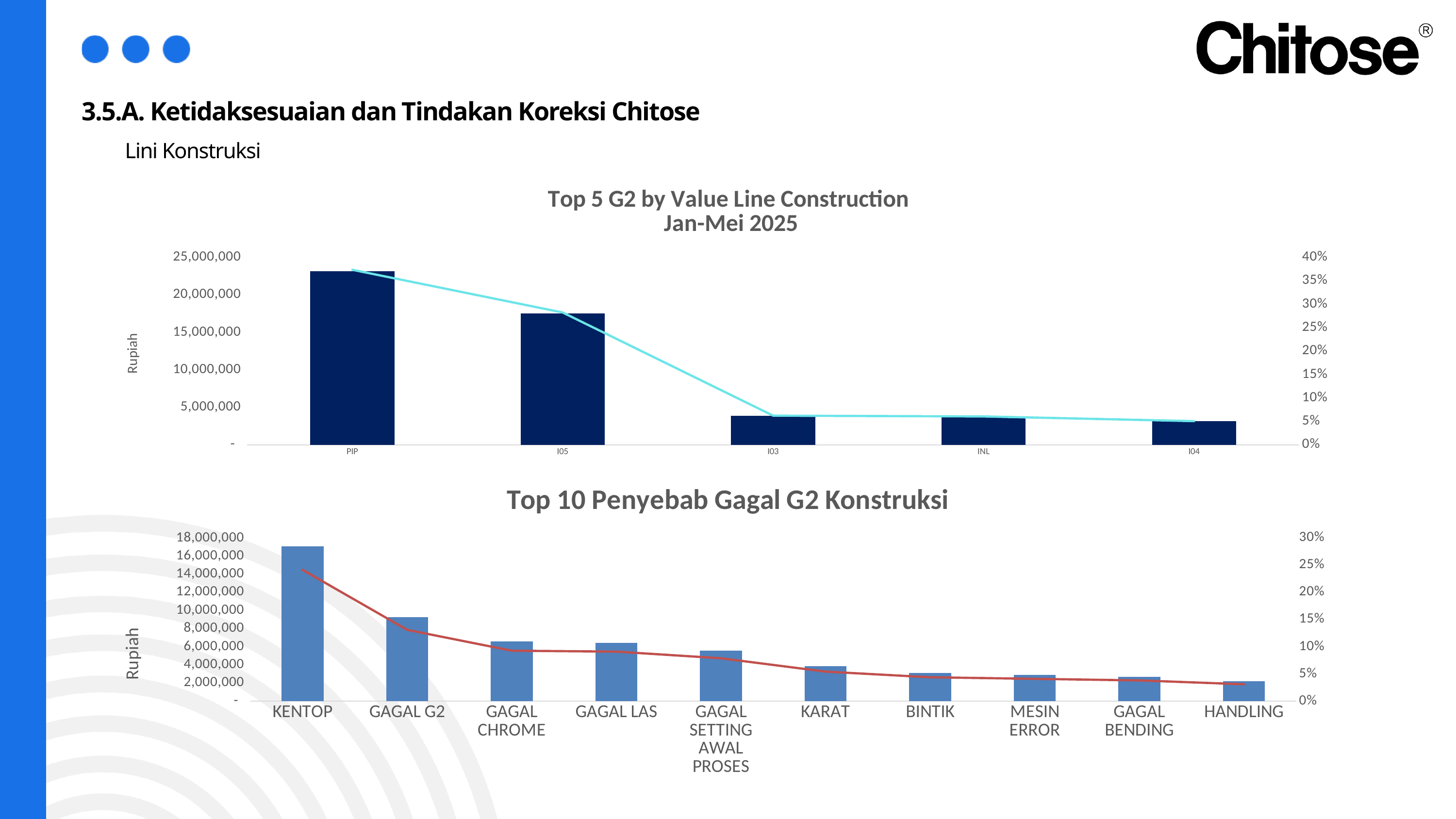
In the chart titled 'Top 5 G2 by Value Line Construction Jan-Mei 2025', do the bar values rise or fall from left to right? fall In the chart titled 'Top 5 G2 by Value Line Construction Jan-Mei 2025', is the bar for I05 greater or less than 20,000,000? less How many categories are shown on the x axis of the chart titled 'Top 5 G2 by Value Line Construction Jan-Mei 2025'? 5 In the chart titled 'Top 10 Penyebab Gagal G2 Konstruksi', is the bar for KENTOP greater or less than 16,000,000? greater In the chart titled 'Top 5 G2 by Value Line Construction Jan-Mei 2025', is the bar for I03 greater or less than 5,000,000? less In the chart titled 'Top 10 Penyebab Gagal G2 Konstruksi', which bar is larger, GAGAL G2 or GAGAL SETTING AWAL PROSES? GAGAL G2 In the chart titled 'Top 5 G2 by Value Line Construction Jan-Mei 2025', which category has the highest bar? PIP How many categories are shown on the x axis of the chart titled 'Top 10 Penyebab Gagal G2 Konstruksi'? 10 In the chart titled 'Top 10 Penyebab Gagal G2 Konstruksi', which category has the highest bar? KENTOP In the chart titled 'Top 10 Penyebab Gagal G2 Konstruksi', which category has the lowest bar? HANDLING